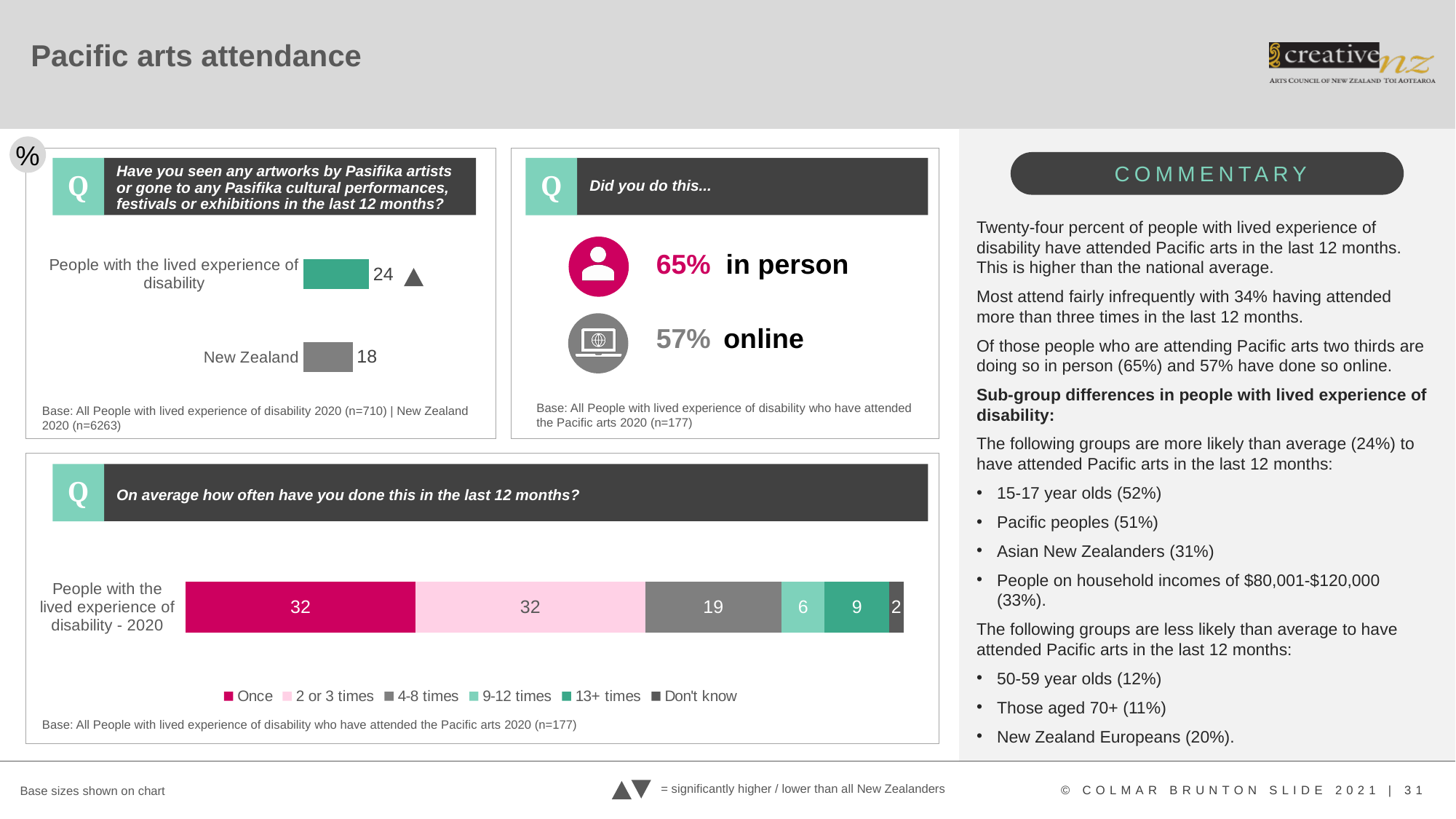
In the bottom stacked bar chart on how often people have done this in the last 12 months, what is the value for 'Once'? 32 In the top-left chart on whether people have seen Pasifika artworks or attended Pasifika cultural events in the last 12 months, what is the value for people with the lived experience of disability? 24 In the bottom stacked bar chart on how often people have done this in the last 12 months, what is the value for '4-8 times'? 19 In the top-left chart on Pasifika arts attendance in the last 12 months, what is the difference between the value for people with the lived experience of disability and the value for New Zealand? 6 In the top-left chart on Pasifika arts attendance in the last 12 months, how many categories are shown? 2 In the bottom stacked bar chart on how often people have done this in the last 12 months, is the value for '13+ times' larger than the value for '9-12 times'? Yes In the bottom stacked bar chart on how often people have done this in the last 12 months, what is the value for '9-12 times'? 6 In the top-left chart on Pasifika arts attendance in the last 12 months, what is the value for New Zealand? 18 In the bottom stacked bar chart on how often people have done this in the last 12 months, how many series does the legend list? 6 In the top-left chart on Pasifika arts attendance in the last 12 months, which category has the higher value? People with the lived experience of disability In the bottom stacked bar chart on how often people have done this in the last 12 months, which segment has the lowest value? Don't know What kind of chart is the top-left chart on Pasifika arts attendance in the last 12 months? Bar chart